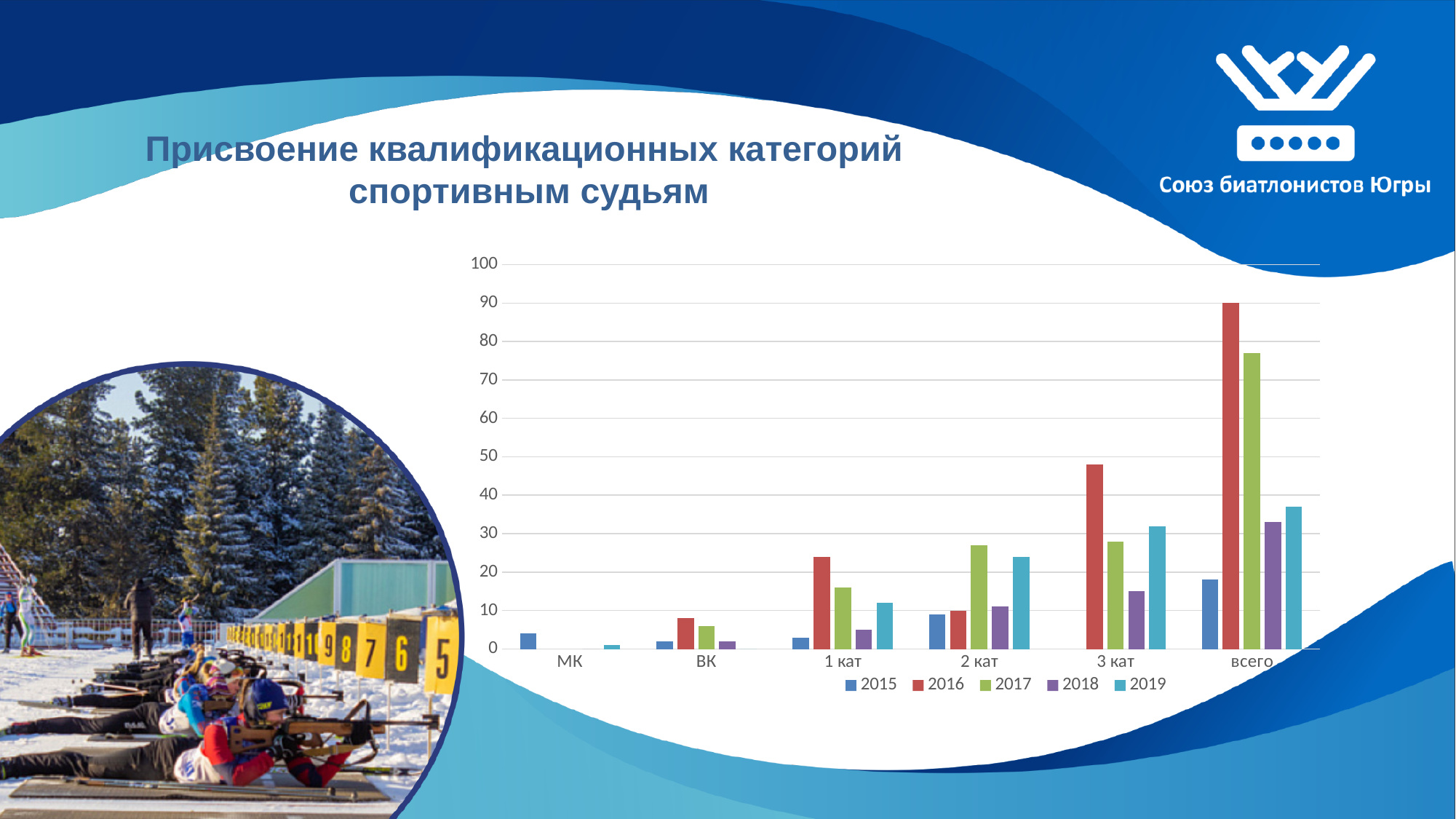
In the "3 кат" category, which is larger: the 2016 bar or the 2017 bar? 2016 Is the value for 2017 in the "всего" category greater or less than 70? greater Is the value for 2016 in the "всего" category greater or less than 80? greater How many categories are shown on the x axis of the chart? 6 How many series does the chart's legend list? 5 Is the value for 2015 in the "всего" category greater or less than 20? less Which series is shown in red in the chart's legend? 2016 What kind of chart is shown on the slide? bar chart Which series has the highest bar in the "всего" category? 2016 Which series has the lowest bar in the "всего" category? 2015